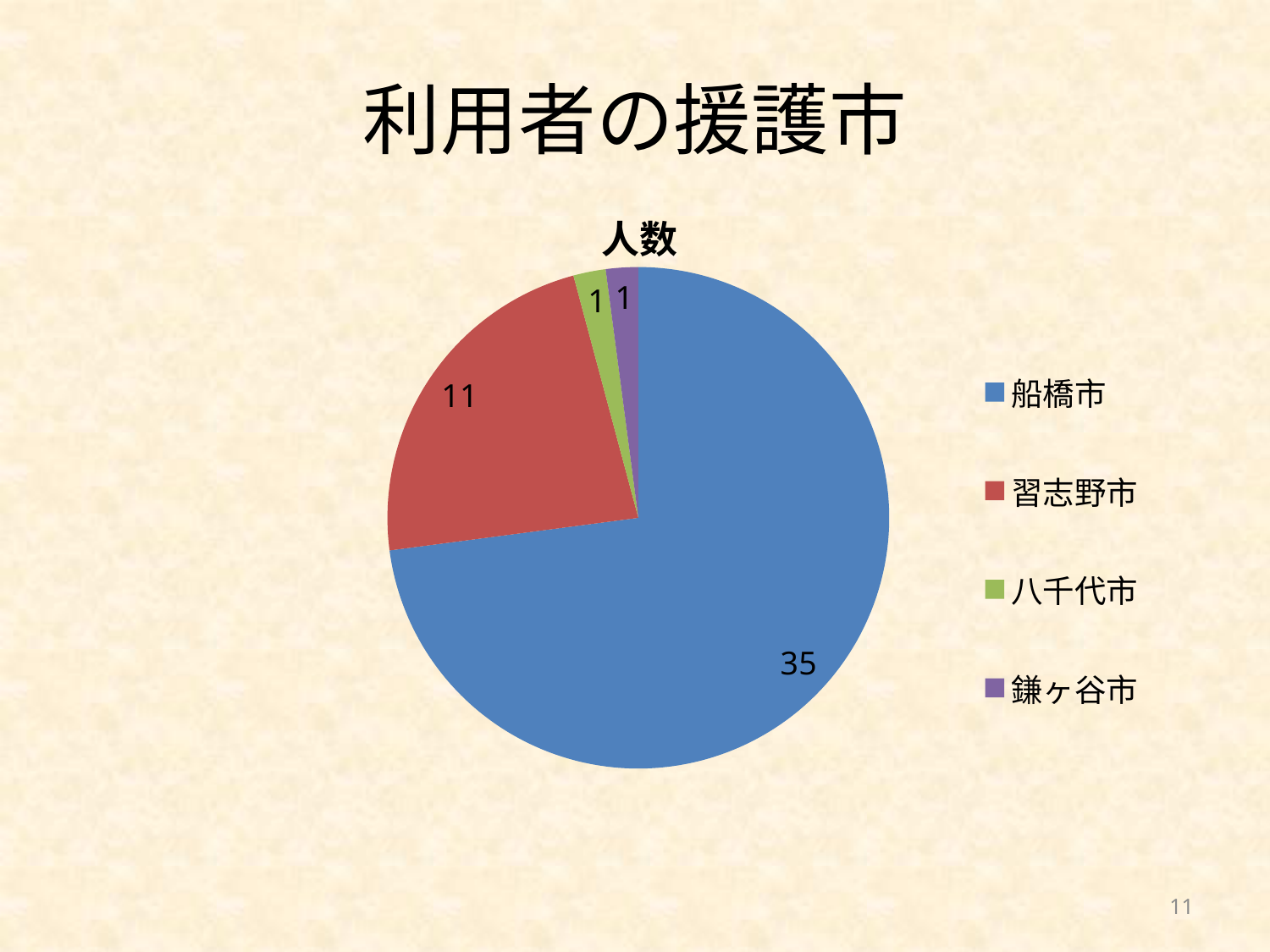
What kind of chart is shown on the slide? Pie chart What is the value for 習志野市 in the pie chart? 11 What is the difference between the values for 船橋市 and 習志野市? 24 What is the value for 八千代市 in the pie chart? 1 What colour is the slice for 船橋市? Blue How many cities are shown in the pie chart? 4 What is the total of all the values in the pie chart? 48 What is the value for 鎌ヶ谷市 in the pie chart? 1 Which is larger, the value for 習志野市 or the value for 八千代市? 習志野市 What is the value for 船橋市 in the pie chart? 35 What is the title of the chart? 人数 Which city has the largest slice in the pie chart? 船橋市